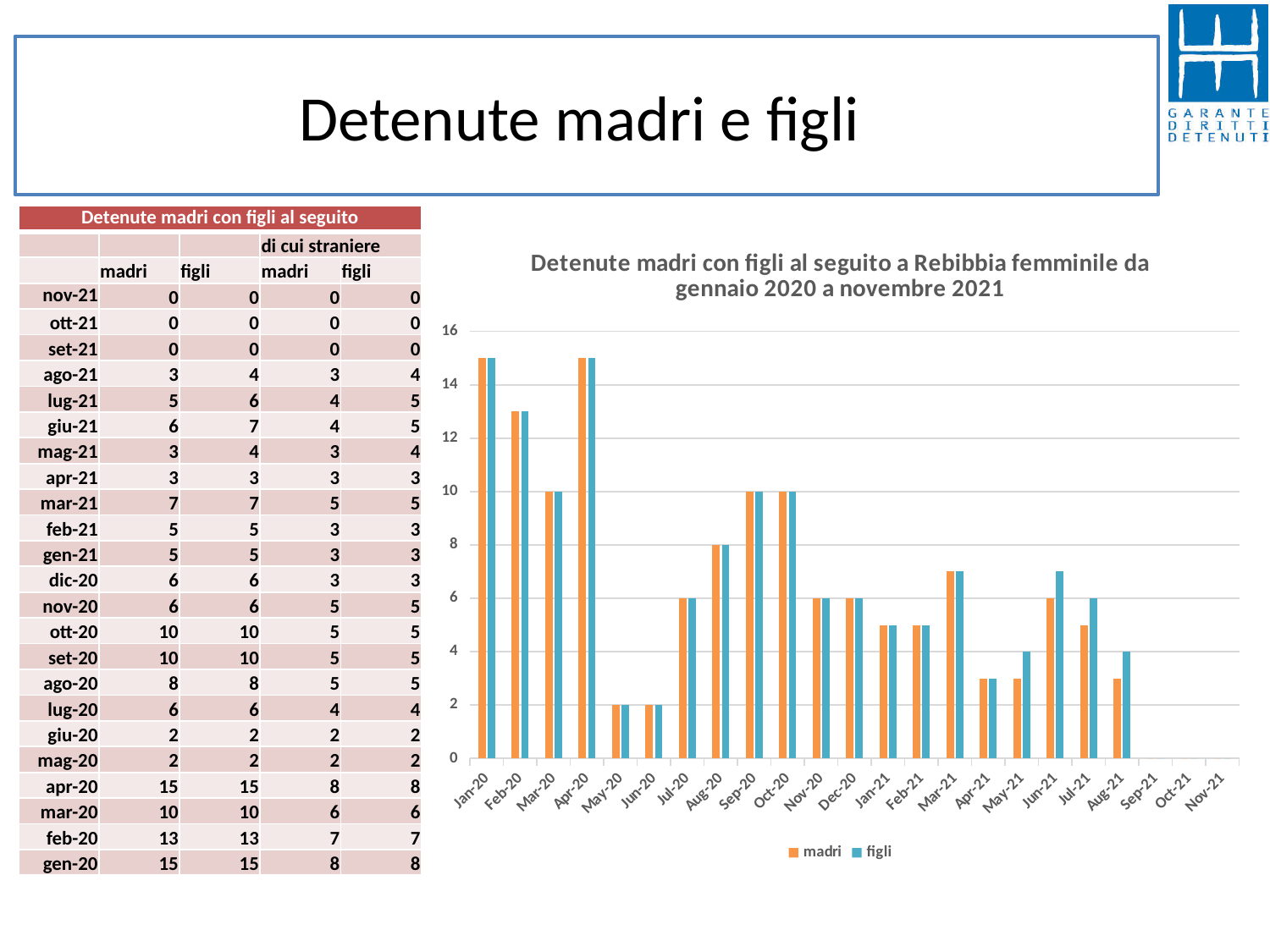
How many series does the chart legend list? 2 What is the value for figli in Jun-21? 7 Is the value for madri in Apr-20 greater or less than 14? greater Which month has the lowest non-zero value for madri? May-20 and Jun-20 Is the value for figli in Aug-21 greater or less than 6? less Do the values for madri rise or fall from Jan-20 to Jun-20? fall Which is larger, the value for madri in Mar-20 or the value for madri in Aug-20? Mar-20 What is the value for madri in Sep-20? 10 What type of chart is shown on the slide? bar chart What is the difference between the figli value in Jun-21 and the madri value in Jun-21? 1 What is the value for madri in Jan-20? 15 What is the value for figli in Feb-20? 13